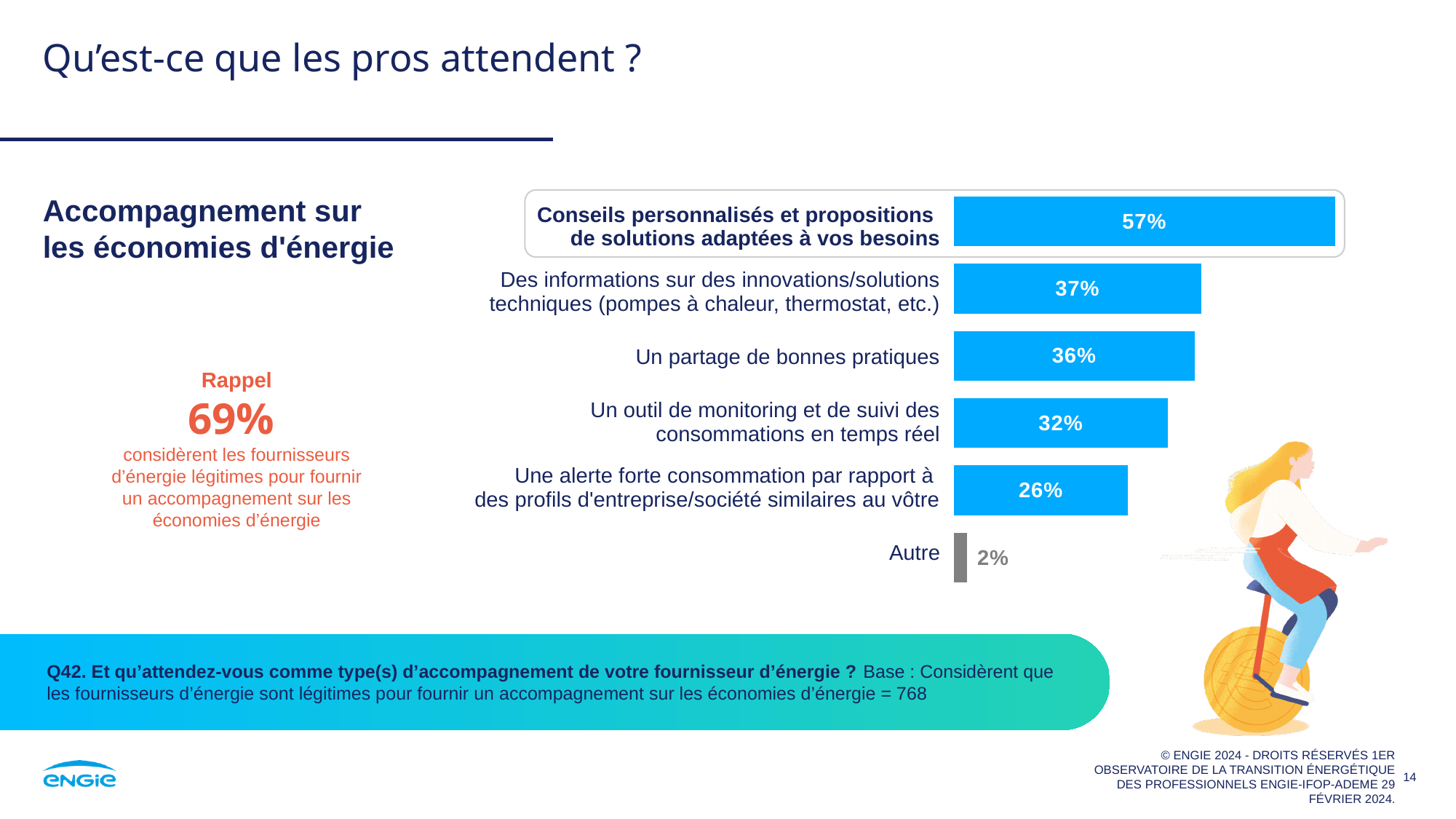
What is the value for "Un partage de bonnes pratiques"? 36% What is the difference between the value for "Conseils personnalisés et propositions de solutions adaptées à vos besoins" and the value for "Des informations sur des innovations/solutions techniques"? 20 percentage points What is the value for "Autre"? 2% Which category has the lowest value in the chart? Autre Which category has the highest value in the chart? Conseils personnalisés et propositions de solutions adaptées à vos besoins What is the value for "Un outil de monitoring et de suivi des consommations en temps réel"? 32% Which is larger: the value for "Un outil de monitoring et de suivi des consommations en temps réel" or the value for "Une alerte forte consommation par rapport à des profils d'entreprise/société similaires au vôtre"? Un outil de monitoring et de suivi des consommations en temps réel How many categories are shown in the bar chart? 6 What percentage of respondents expect "Conseils personnalisés et propositions de solutions adaptées à vos besoins"? 57% What kind of chart is shown on the slide? Bar chart What is the difference between the value for "Des informations sur des innovations/solutions techniques" and the value for "Un partage de bonnes pratiques"? 1 percentage point Which bar in the chart is coloured grey rather than blue? Autre